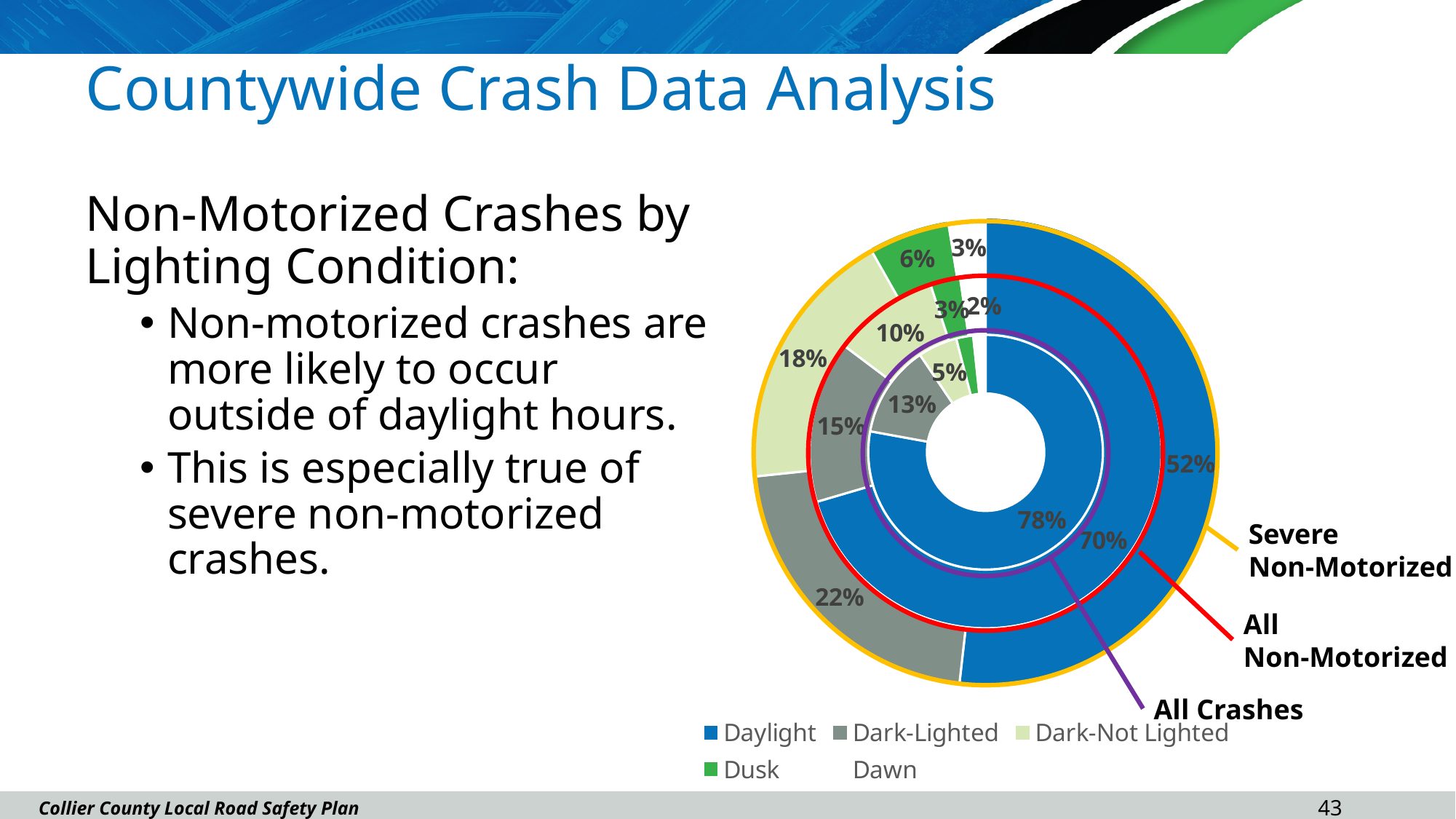
Which ring of the chart represents All Crashes: the inner, middle, or outer ring? Inner ring What share of All Non-Motorized crashes occurred in Dark-Lighted conditions? 15% What is the difference between the Daylight share for All Crashes and the Daylight share for Severe Non-Motorized crashes? 26% What share of Severe Non-Motorized crashes occurred in Daylight? 52% How many lighting conditions does the legend list? 5 What share of Severe Non-Motorized crashes occurred in Dark-Not Lighted conditions? 18% What type of chart is shown on the slide? Doughnut chart What share of All Crashes occurred in Daylight? 78% Which is larger: the Dark-Lighted share for Severe Non-Motorized crashes or for All Crashes? Severe Non-Motorized What share of All Non-Motorized crashes occurred in Daylight? 70% What share of Severe Non-Motorized crashes occurred at Dusk? 6% Which lighting condition has the largest share in the Severe Non-Motorized ring? Daylight